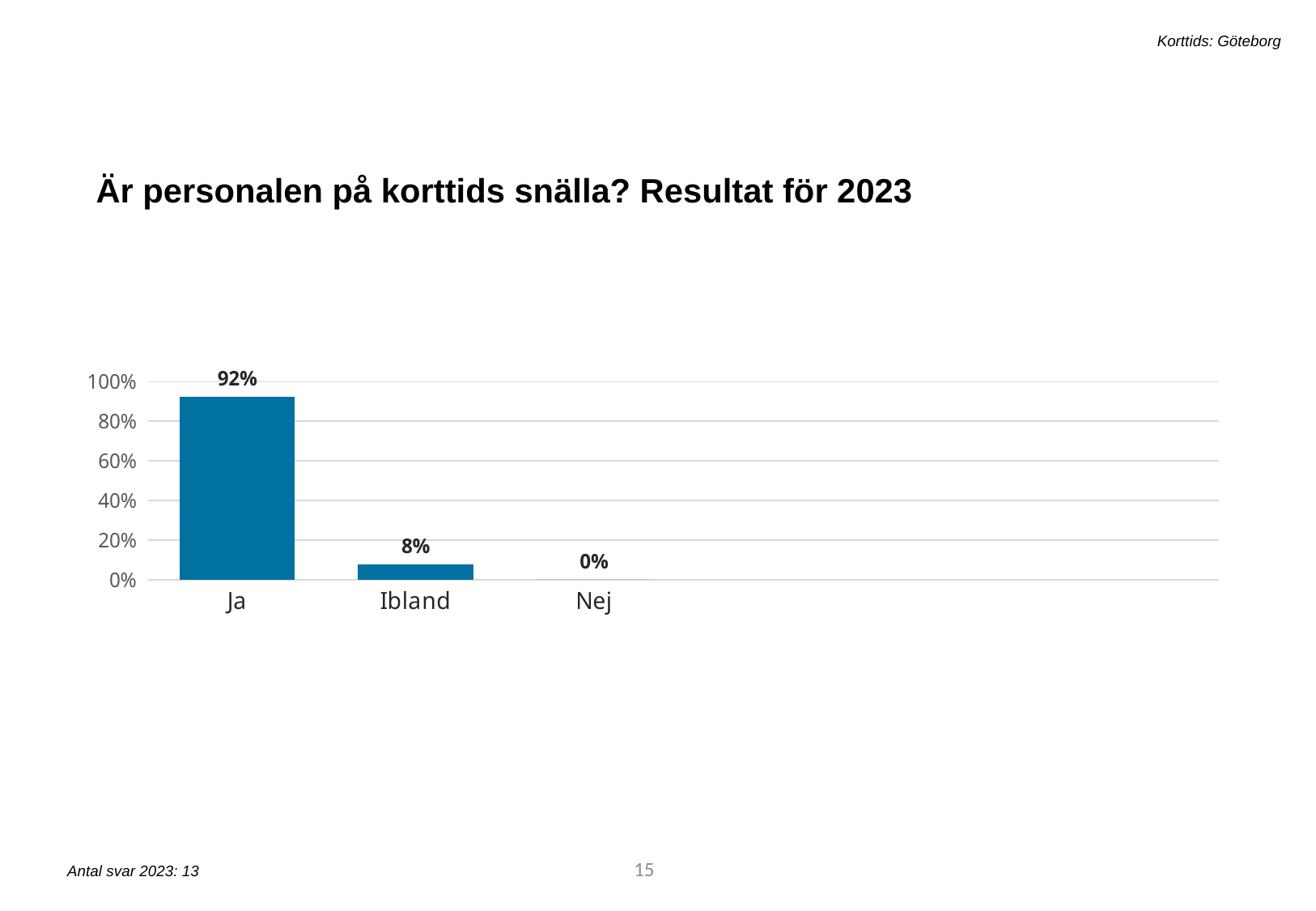
What is the title of the chart on the slide? Är personalen på korttids snälla? Resultat för 2023 What kind of chart is shown on the slide? bar chart Which is larger, the value for Ibland or the value for Nej? Ibland What is the difference between the values for Ja and Ibland? 84% Do the values rise or fall from left to right along the x axis? fall What is the value for Nej? 0% What is the value for Ja? 92% How many categories are shown on the x axis? 3 Is the value for Ja greater or less than 80%? greater Which category has the highest value? Ja Which category has the lowest value? Nej What is the value for Ibland? 8%